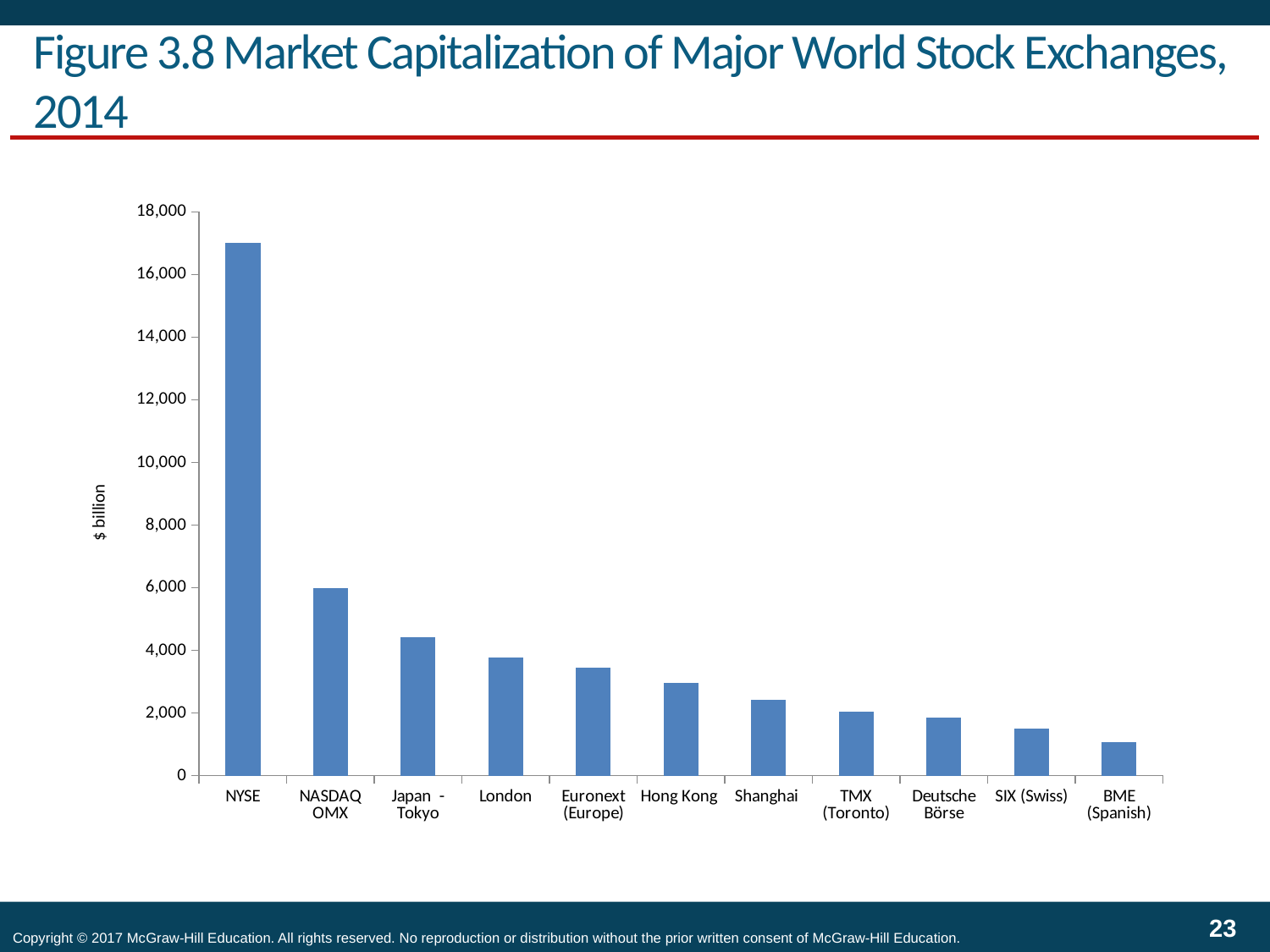
Is the value for SIX (Swiss) greater or less than 2,000? less Is the value for London greater or less than 4,000? less How many stock exchanges are shown in the chart? 11 Do the values rise or fall moving from left to right along the x axis? Fall Which has a larger market capitalization, NASDAQ OMX or London? NASDAQ OMX Is the value for Hong Kong greater or less than 2,000? greater Which stock exchange has the highest market capitalization in the chart? NYSE What is the label on the vertical axis of the chart? $ billion What kind of chart is shown on the slide? Bar chart Which stock exchange has the lowest market capitalization in the chart? BME (Spanish)